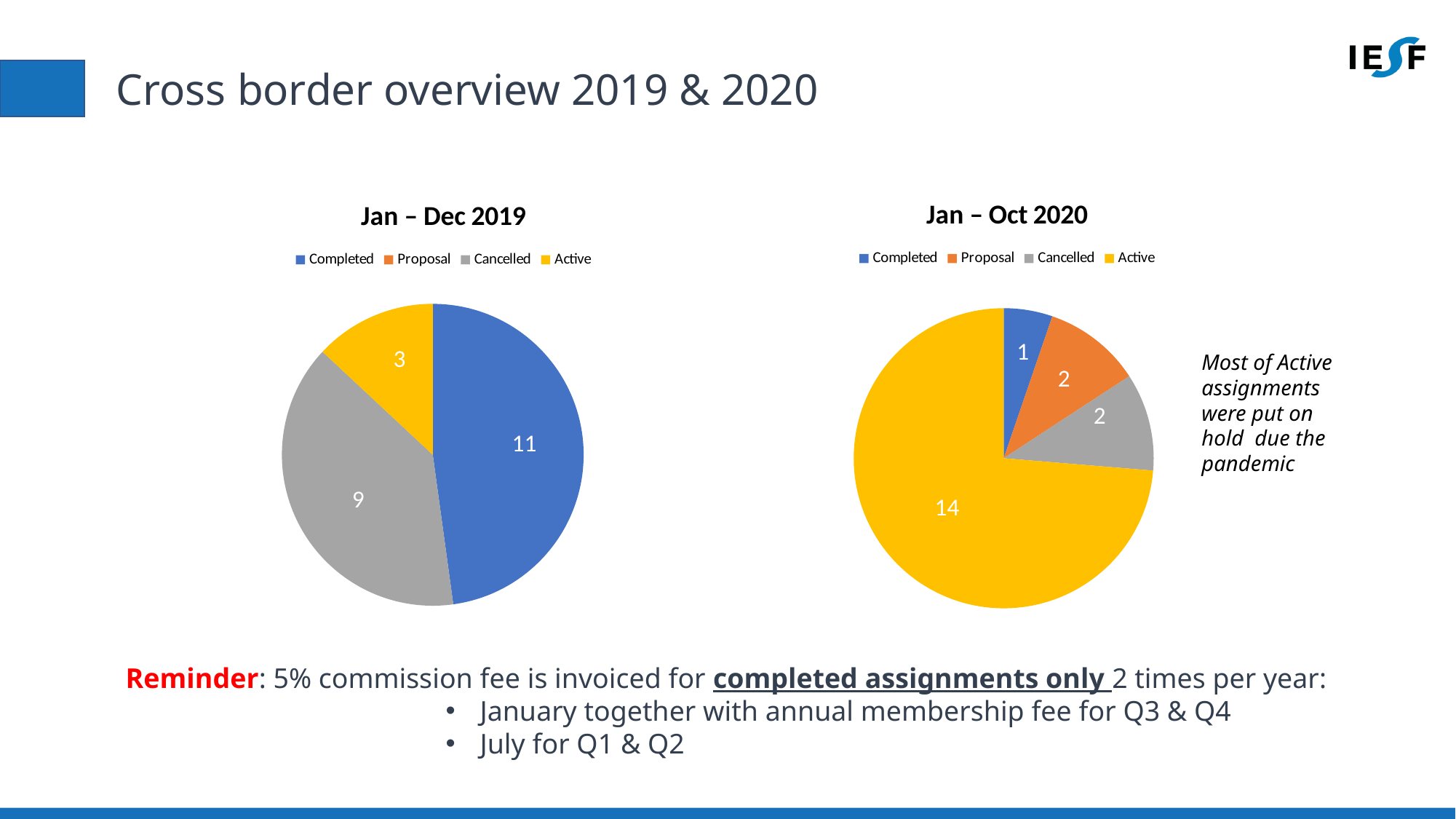
Which is larger: Active in the Jan – Dec 2019 chart or Active in the Jan – Oct 2020 chart? Jan – Oct 2020 In the Jan – Oct 2020 pie chart, what is the value for Completed? 1 In the Jan – Dec 2019 pie chart, which category has the largest slice? Completed In the Jan – Oct 2020 pie chart, which category has the smallest slice? Completed In the Jan – Oct 2020 pie chart, how much larger is the Active value than the Cancelled value? 12 In the Jan – Oct 2020 pie chart, what is the value for Proposal? 2 In the Jan – Dec 2019 pie chart, what is the value for Cancelled? 9 What type of chart is used for the Jan – Oct 2020 data? Pie chart In the Jan – Dec 2019 pie chart, what is the value for Active? 3 In the Jan – Dec 2019 pie chart, what is the value for Completed? 11 In the Jan – Dec 2019 pie chart, what is the difference between the Completed and Cancelled values? 2 In the Jan – Oct 2020 pie chart, what is the value for Active? 14